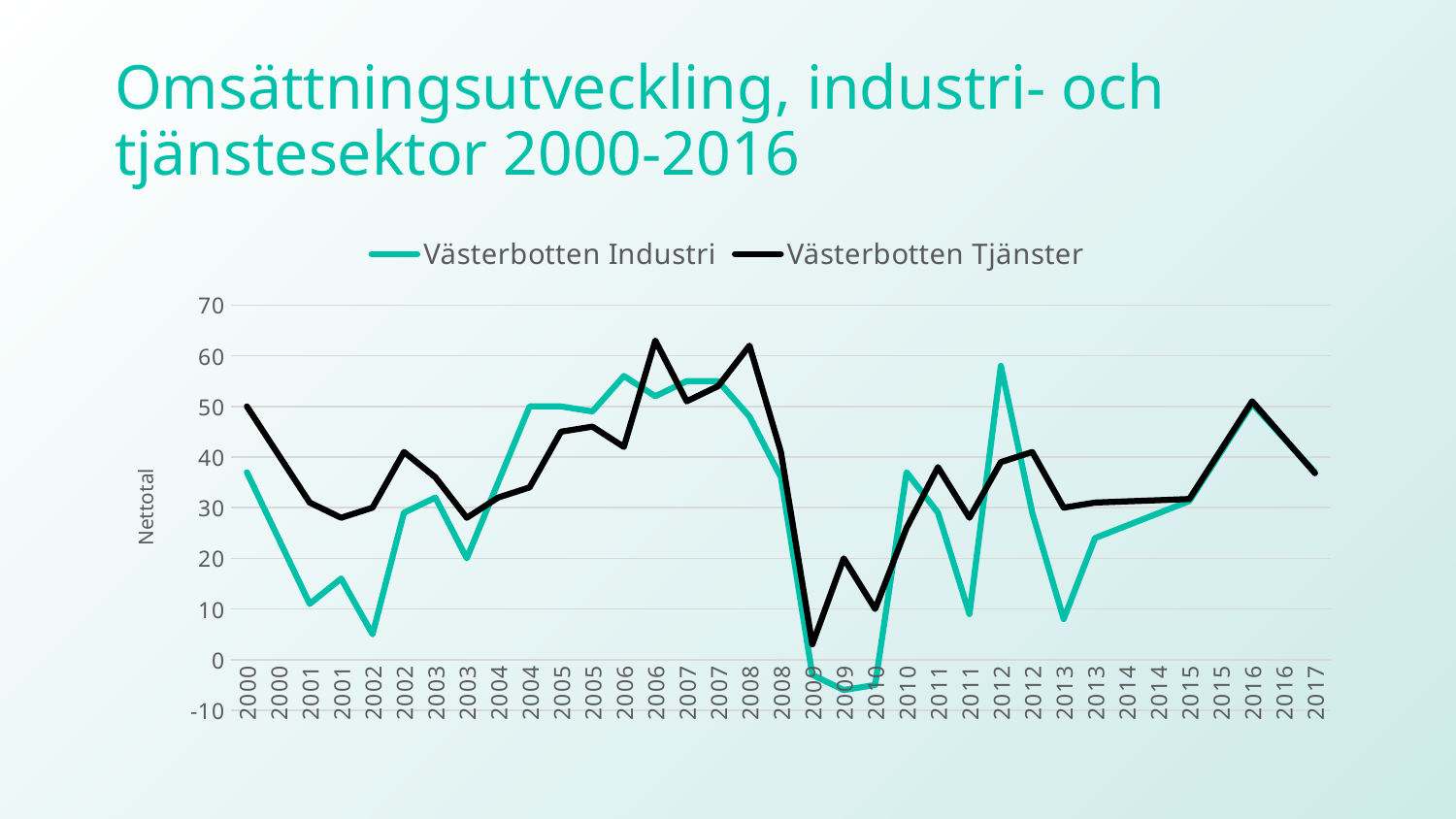
How many series does the legend list? 2 What kind of chart is shown on the slide? Line chart At the first 2012 point, which series has the higher value, Västerbotten Industri or Västerbotten Tjänster? Västerbotten Industri At the first 2002 point, which series has the higher value, Västerbotten Industri or Västerbotten Tjänster? Västerbotten Tjänster What are the two series named in the legend? Västerbotten Industri and Västerbotten Tjänster Does the Västerbotten Industri line rise or fall between 2008 and 2009? Fall What is the label on the vertical axis? Nettotal Is the value for Västerbotten Industri at the second 2009 point greater or less than 0? less Is the value for Västerbotten Industri at the first 2000 point greater or less than 30? greater Is the highest value for Västerbotten Tjänster in 2006 greater or less than 60? greater Which series reaches the lowest value anywhere on the chart? Västerbotten Industri